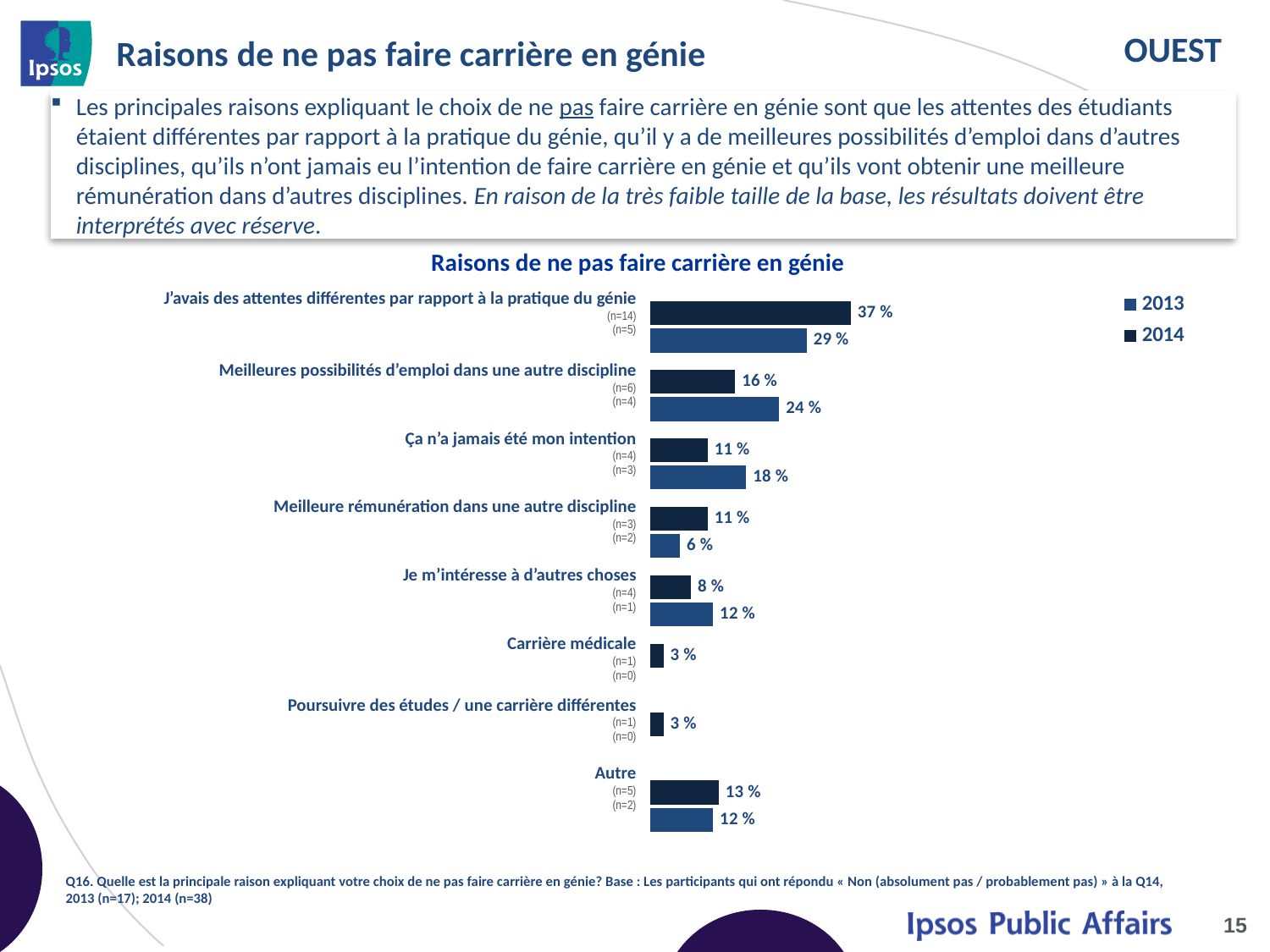
What kind of chart is shown on the slide? bar chart Which category has the highest value in the chart? J'avais des attentes différentes par rapport à la pratique du génie How many reason categories are shown in the chart? 8 What is the 2013 value for 'Meilleures possibilités d'emploi dans une autre discipline'? 24 % What is the 2013 value for 'J'avais des attentes différentes par rapport à la pratique du génie'? 29 % How many series does the legend list? 2 What is the difference between the 2014 and 2013 values for 'J'avais des attentes différentes par rapport à la pratique du génie'? 8 % What is the 2014 value for 'J'avais des attentes différentes par rapport à la pratique du génie'? 37 % What is the difference between the 2014 and 2013 values for 'Ça n'a jamais été mon intention'? 7 % What is the title of the chart? Raisons de ne pas faire carrière en génie What is the 2014 value for 'Autre'? 13 % For 'Meilleure rémunération dans une autre discipline', which year has the larger value, 2013 or 2014? 2014